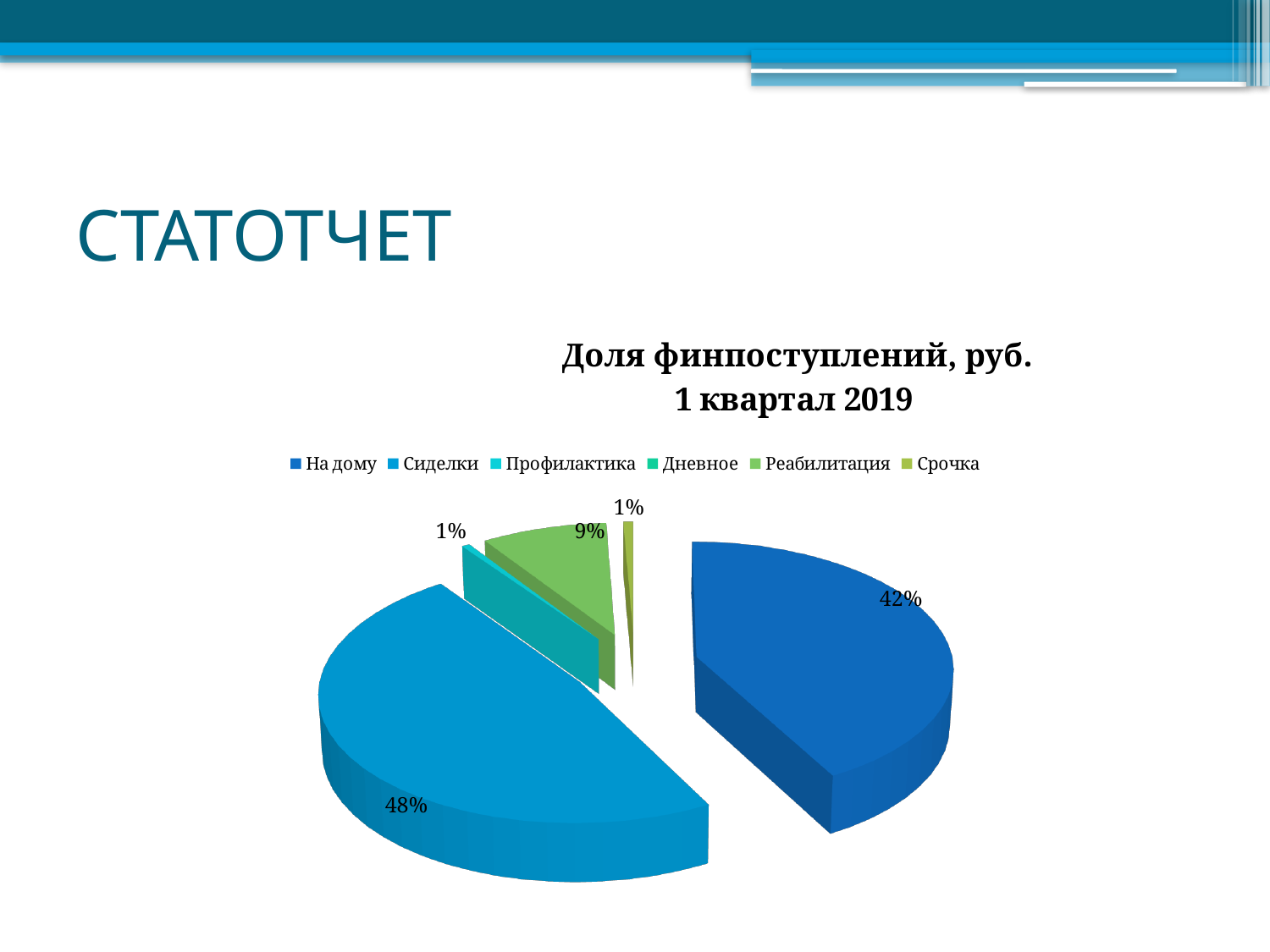
What share of the pie does На дому account for? 42% What is the difference in percentage points between the Сиделки share and the На дому share? 6 Which legend entry is listed first in the chart legend? На дому How many categories does the chart legend list? 6 What kind of chart is shown on the slide? pie chart What is the difference in percentage points between the На дому share and the Реабилитация share? 33 What share of the pie does Реабилитация account for? 9% Which is larger, the share for Сиделки or the share for На дому? Сиделки What share of the pie does Сиделки account for? 48% Which category has the largest share of the pie? Сиделки What is the title of the chart? Доля финпоступлений, руб. 1 квартал 2019 Which is larger, the share for На дому or the share for Реабилитация? На дому